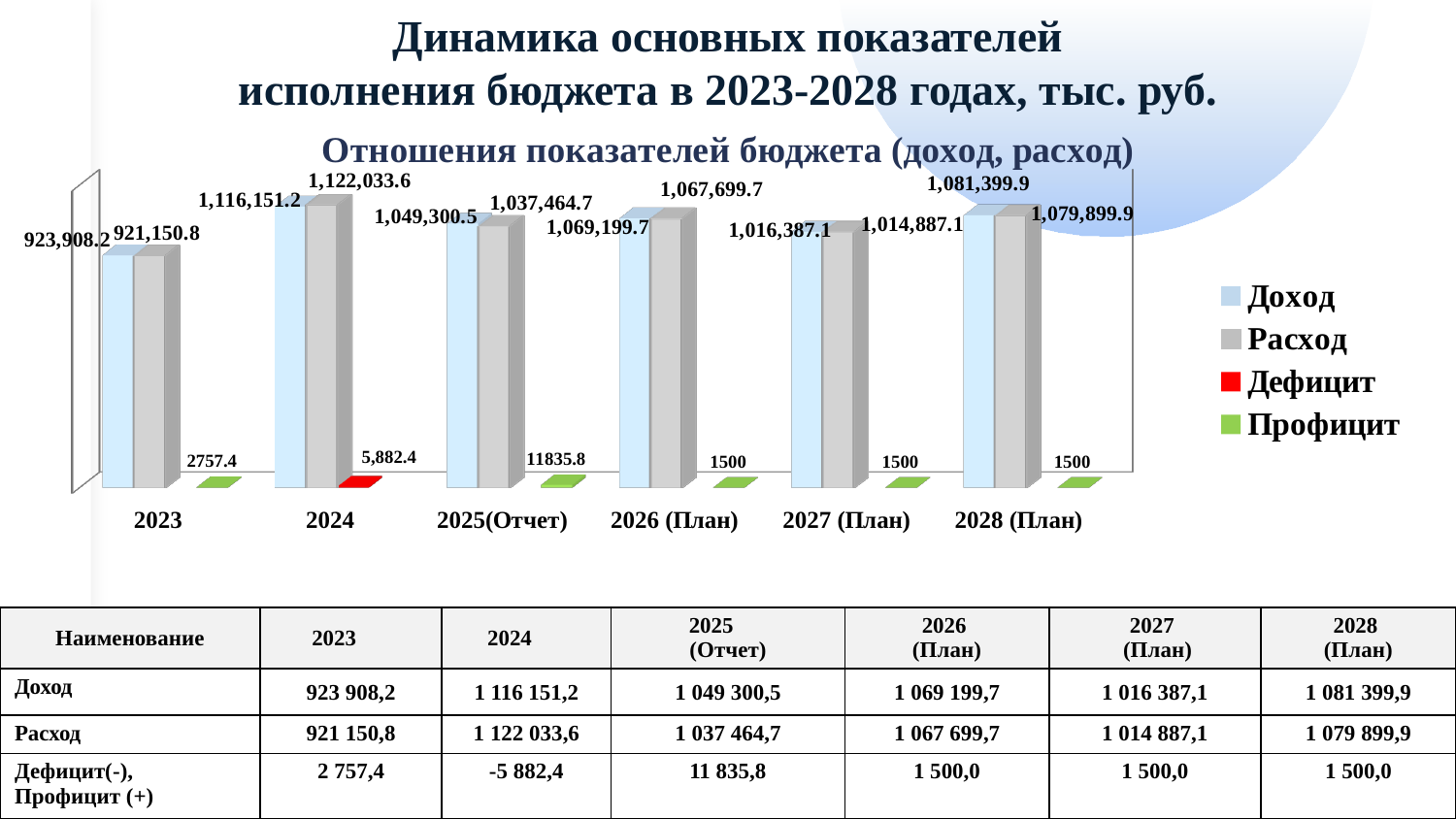
Which year has the highest Доход value? 2024 For 2024, which is larger: Доход or Расход? Расход What is the value of Доход for 2023? 923,908.2 How many year categories are shown on the x axis? 6 Which year has the lowest Расход value? 2023 What is the value of Расход for 2028 (План)? 1,079,899.9 What kind of chart is shown on the slide? Bar chart What is the value of Профицит for 2025(Отчет)? 11835.8 How many series does the legend list? 4 What colour represents Дефицит in the legend? Red Does the Доход value rise or fall from 2023 to 2024? Rise What is the difference between Доход and Расход for 2023? 2,757.4